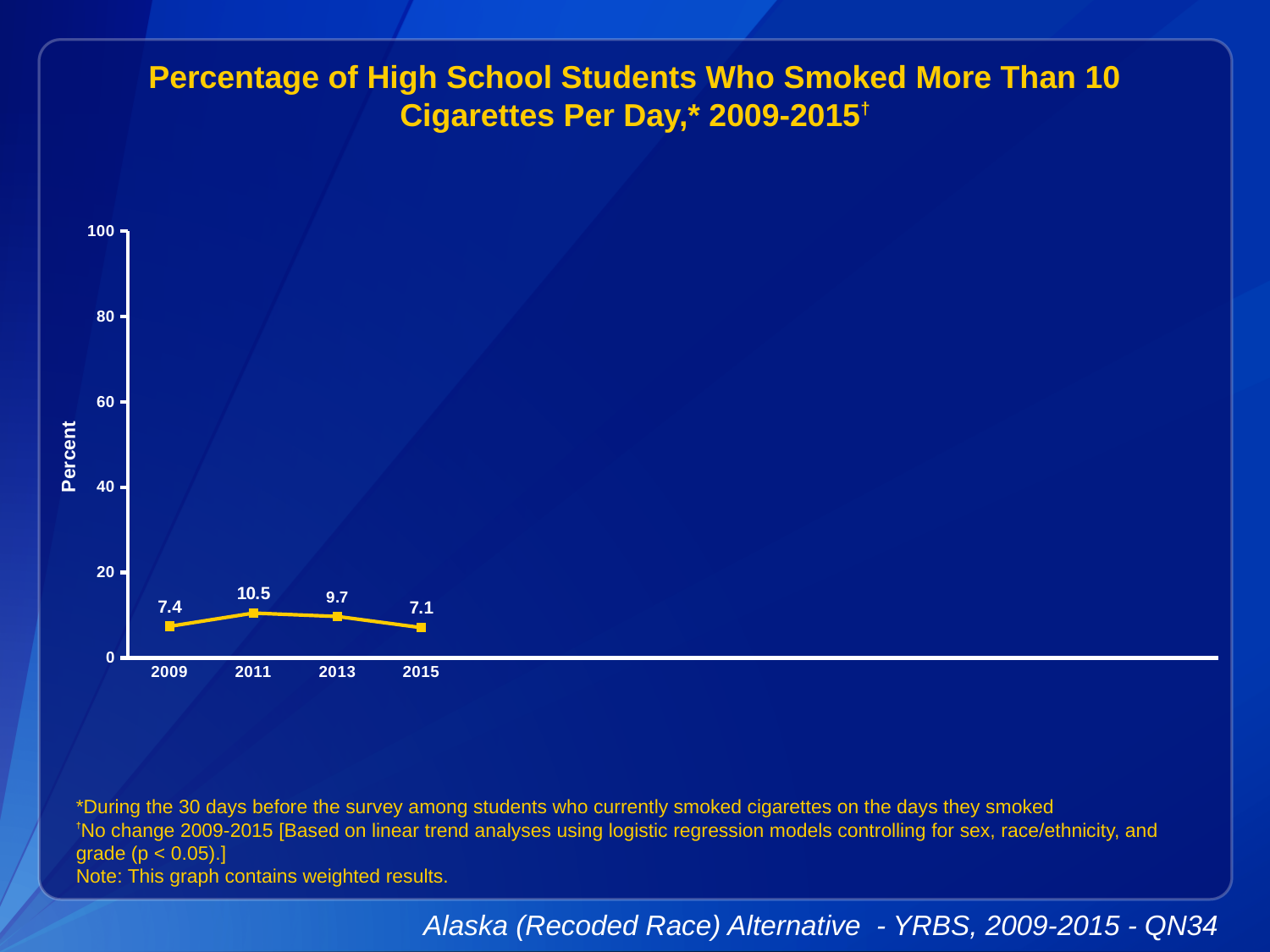
What is the value for 2013? 9.7 Which is larger, the value for 2009 or the value for 2013? 2013 What is the value for 2011? 10.5 What is the difference between the values for 2011 and 2015? 3.4 Which year has the lowest value? 2015 What is the value for 2009? 7.4 What is the label on the y axis? Percent What is the value for 2015? 7.1 Which year has the highest value? 2011 How many years are plotted on the chart? 4 What kind of chart is shown? line chart Is the value for 2011 greater or less than 20? less